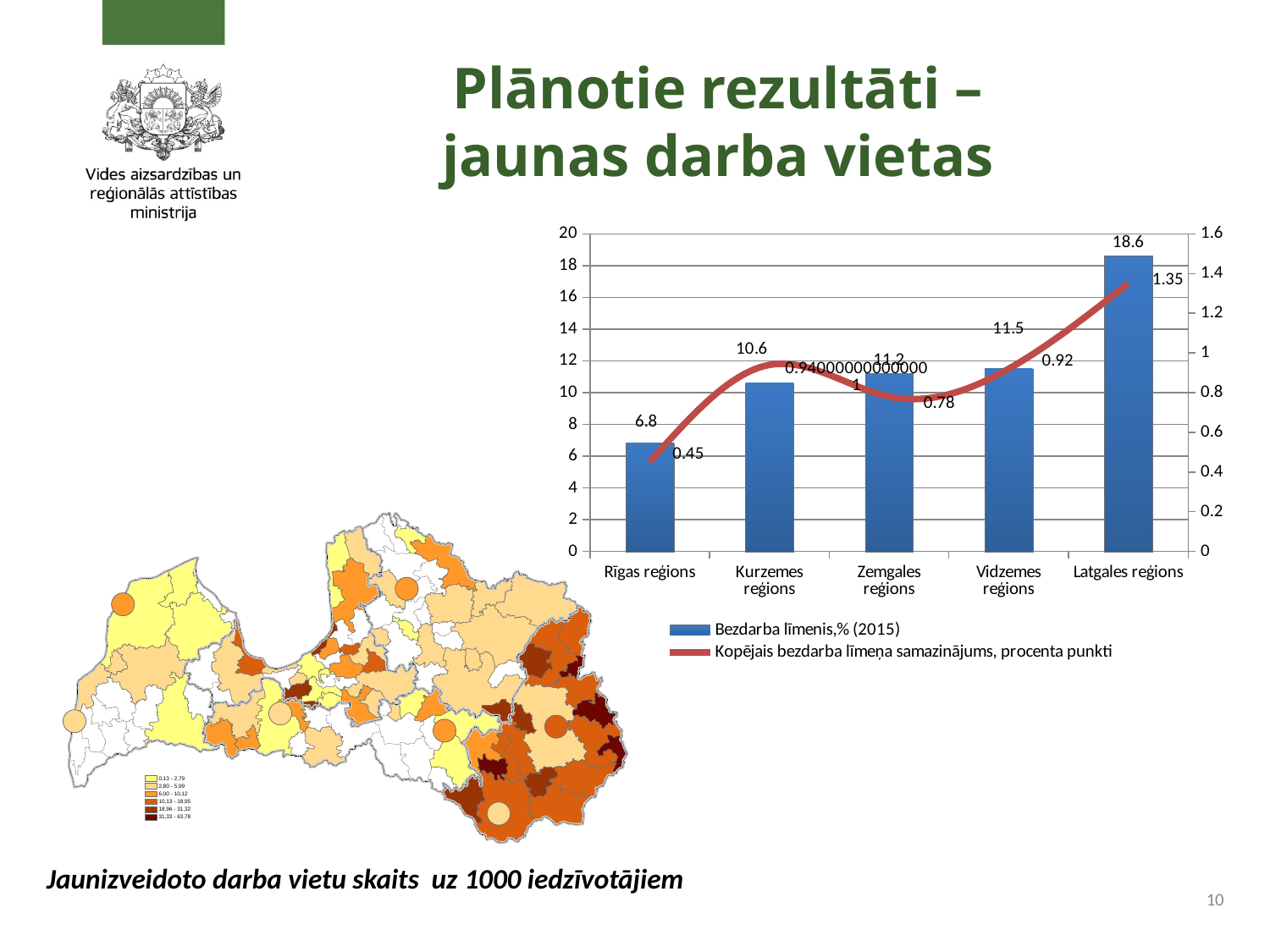
Which region has the lowest Bezdarba līmenis,% (2015) bar? Rīgas reģions Do the Bezdarba līmenis,% (2015) bars rise or fall from Rīgas reģions to Latgales reģions? Rise What is the Bezdarba līmenis,% (2015) value for Latgales reģions? 18.6 Which region has the highest Bezdarba līmenis,% (2015) bar? Latgales reģions What is the Kopējais bezdarba līmeņa samazinājums value for Latgales reģions? 1.35 How many regions are shown on the x axis of the chart? 5 Which has the larger Bezdarba līmenis,% (2015) value, Vidzemes reģions or Zemgales reģions? Vidzemes reģions What is the Bezdarba līmenis,% (2015) value for Rīgas reģions? 6.8 How many series does the chart legend list? 2 What kind of chart is shown on the slide? Bar chart with a line What is the difference between the Bezdarba līmenis,% (2015) values for Latgales reģions and Rīgas reģions? 11.8 What is the Kopējais bezdarba līmeņa samazinājums value for Rīgas reģions? 0.45